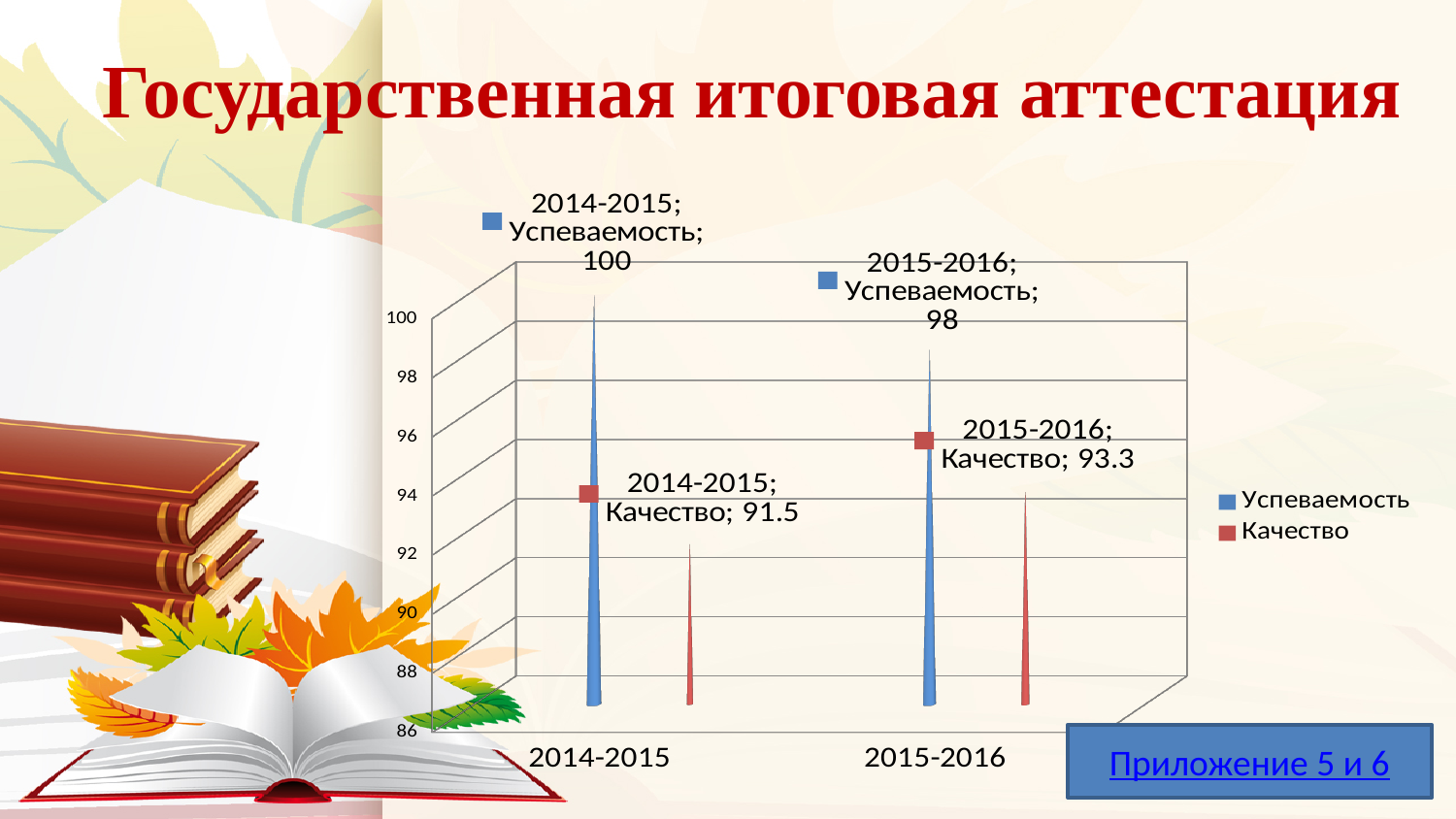
How many series does the legend list? 2 Which is larger: Успеваемость in 2015-2016 or Качество in 2015-2016? Успеваемость in 2015-2016 What is the value of Качество for 2014-2015? 91.5 What is the value of Успеваемость for 2014-2015? 100 In which year is Успеваемость lower? 2015-2016 How many categories are shown on the x axis? 2 What is the difference between Качество in 2015-2016 and 2014-2015? 1.8 What is the value of Успеваемость for 2015-2016? 98 In which year is Качество higher? 2015-2016 What is the value of Качество for 2015-2016? 93.3 Does Качество rise or fall from 2014-2015 to 2015-2016? rise What is the difference between Успеваемость in 2014-2015 and 2015-2016? 2